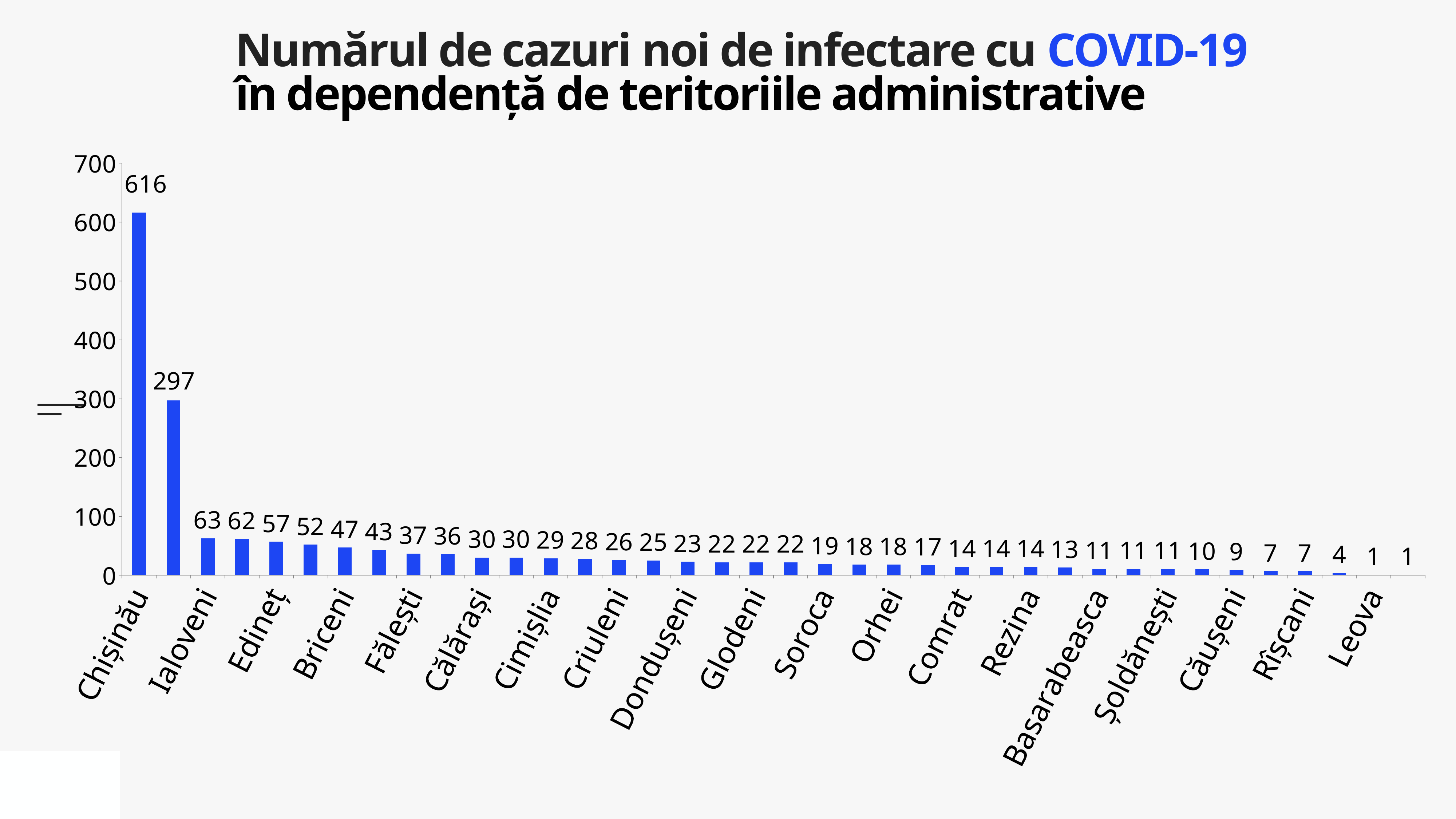
How many new COVID-19 cases are shown for Chișinău? 616 What is the difference between the highest bar (616) and the second-highest bar (297)? 319 Is the value of the second bar greater or less than 300? less What is the lowest value shown on any bar in the chart? 1 Which administrative territory has the highest number of new COVID-19 cases? Chișinău What is the value of the second-highest bar in the chart? 297 What kind of chart is shown on the slide? bar chart Do the bar values rise or fall from left to right along the x axis? fall Is the value for Chișinău greater or less than 600? greater What is the highest value shown on the vertical axis? 700 How many bars are plotted in the chart? 38 What colour are the bars in the chart? blue